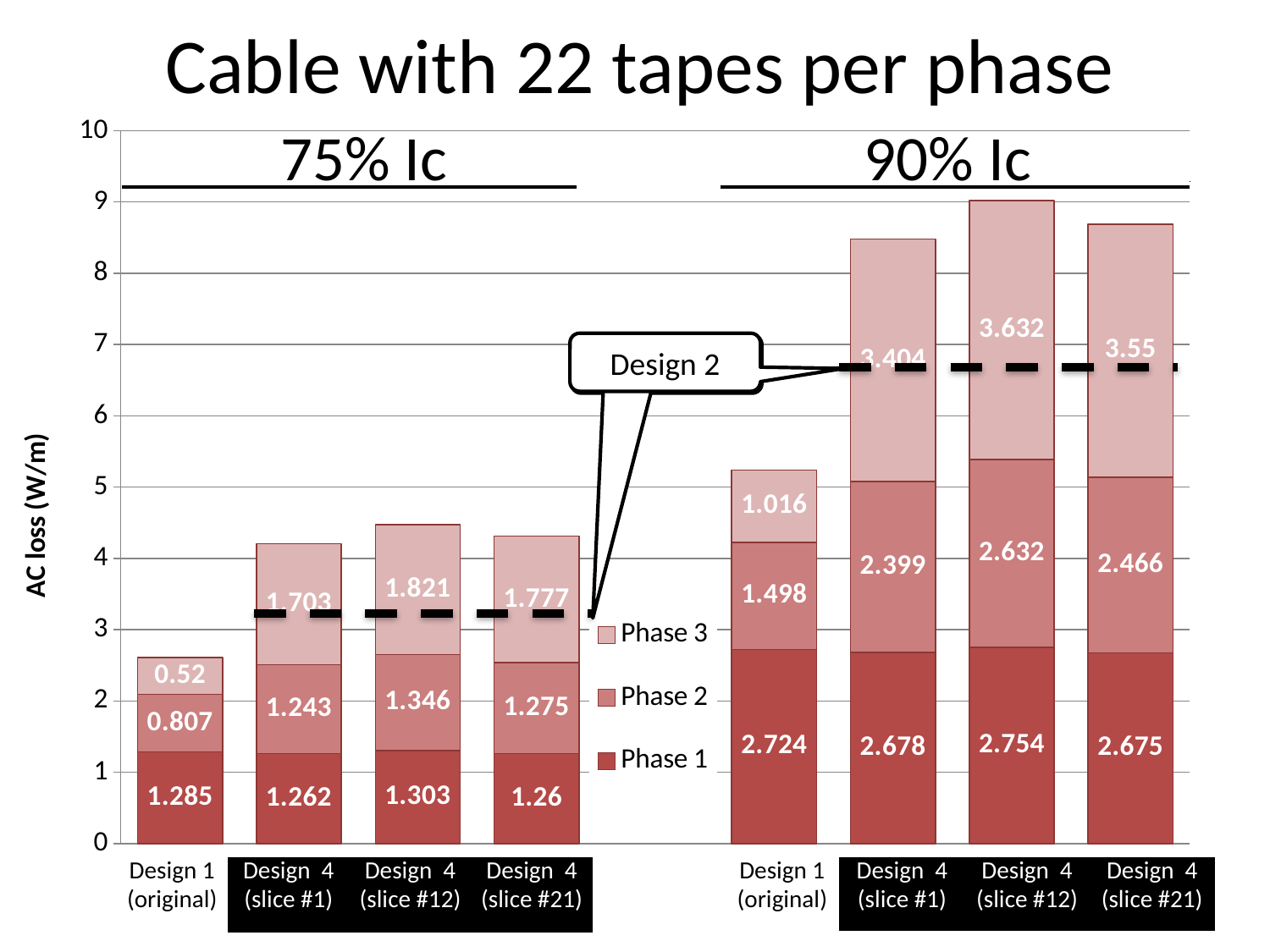
What is the total AC loss for Design 1 (original) in the 75% Ic group? 2.612 What is the Phase 2 value for Design 4 (slice #21) in the 75% Ic group? 1.275 Which bar in the 75% Ic group has the lowest Phase 3 value? Design 1 (original) What is the Phase 3 value for Design 4 (slice #12) in the 90% Ic group? 3.632 What is the Phase 1 value for Design 1 (original) in the 75% Ic group? 1.285 Is the Phase 2 value for Design 4 (slice #12) in the 90% Ic group larger than the Phase 2 value for Design 4 (slice #21) in the same group? Yes What is the Phase 1 value for Design 1 (original) in the 90% Ic group? 2.724 Which bar in the 90% Ic group has the highest Phase 3 value? Design 4 (slice #12) How many series does the legend list? 3 What is the label of the y axis? AC loss (W/m) What is the difference between the Phase 3 values of Design 4 (slice #12) and Design 4 (slice #1) in the 75% Ic group? 0.118 What type of chart is shown on the slide? stacked bar chart